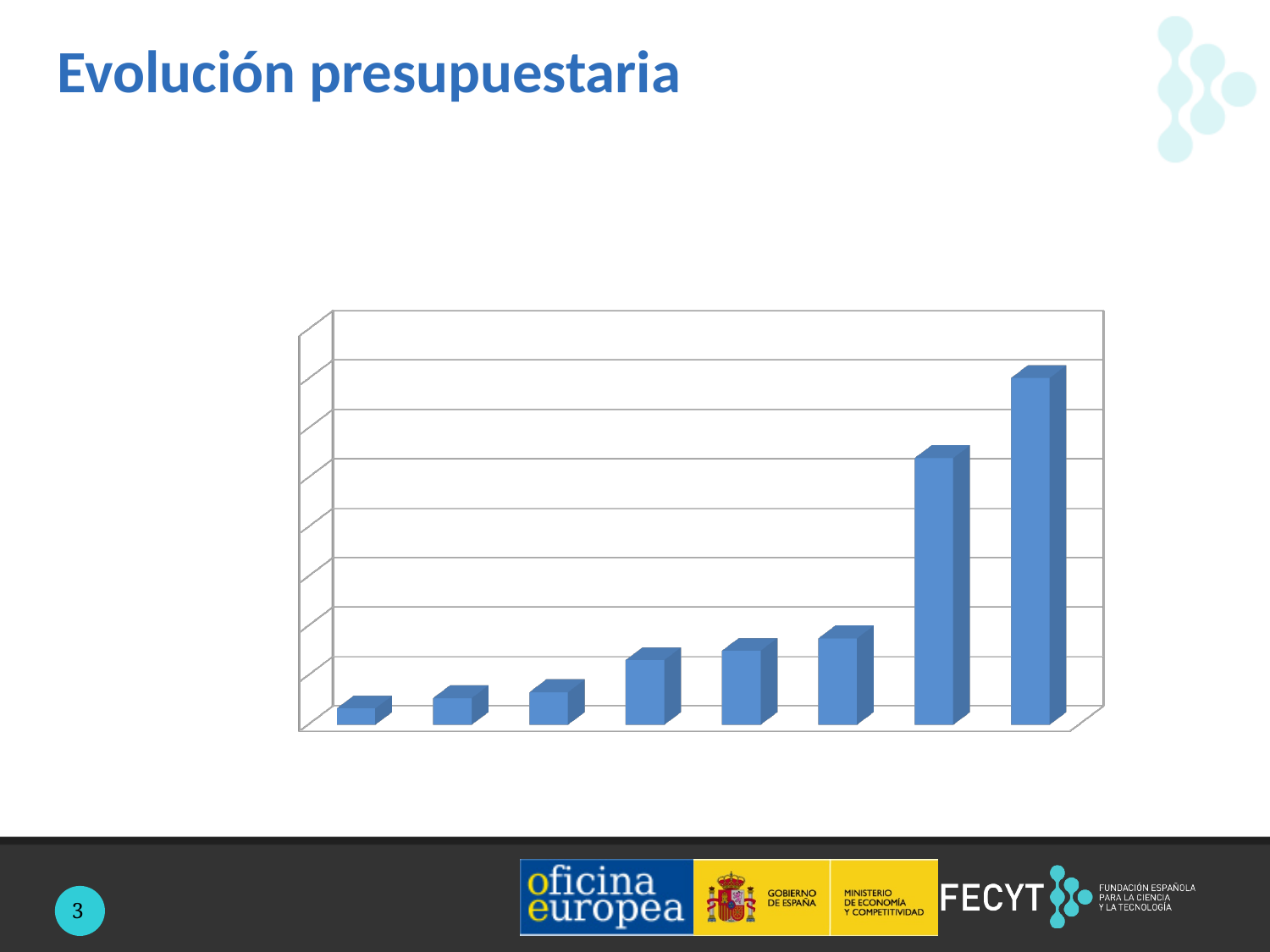
How many bars does the chart contain? 8 What colour are the bars in the chart? blue What kind of chart is shown on the slide? bar chart Do the bar values generally rise or fall from left to right along the x axis? rise Which is taller, the fourth bar or the second bar? the fourth bar Which bar is the shortest in the chart? the leftmost (first) bar Which is taller, the sixth bar or the seventh bar? the seventh bar What is the title of the slide containing the chart? Evolución presupuestaria Which is taller, the seventh bar or the eighth bar? the eighth bar Which bar is the tallest in the chart? the rightmost (eighth) bar